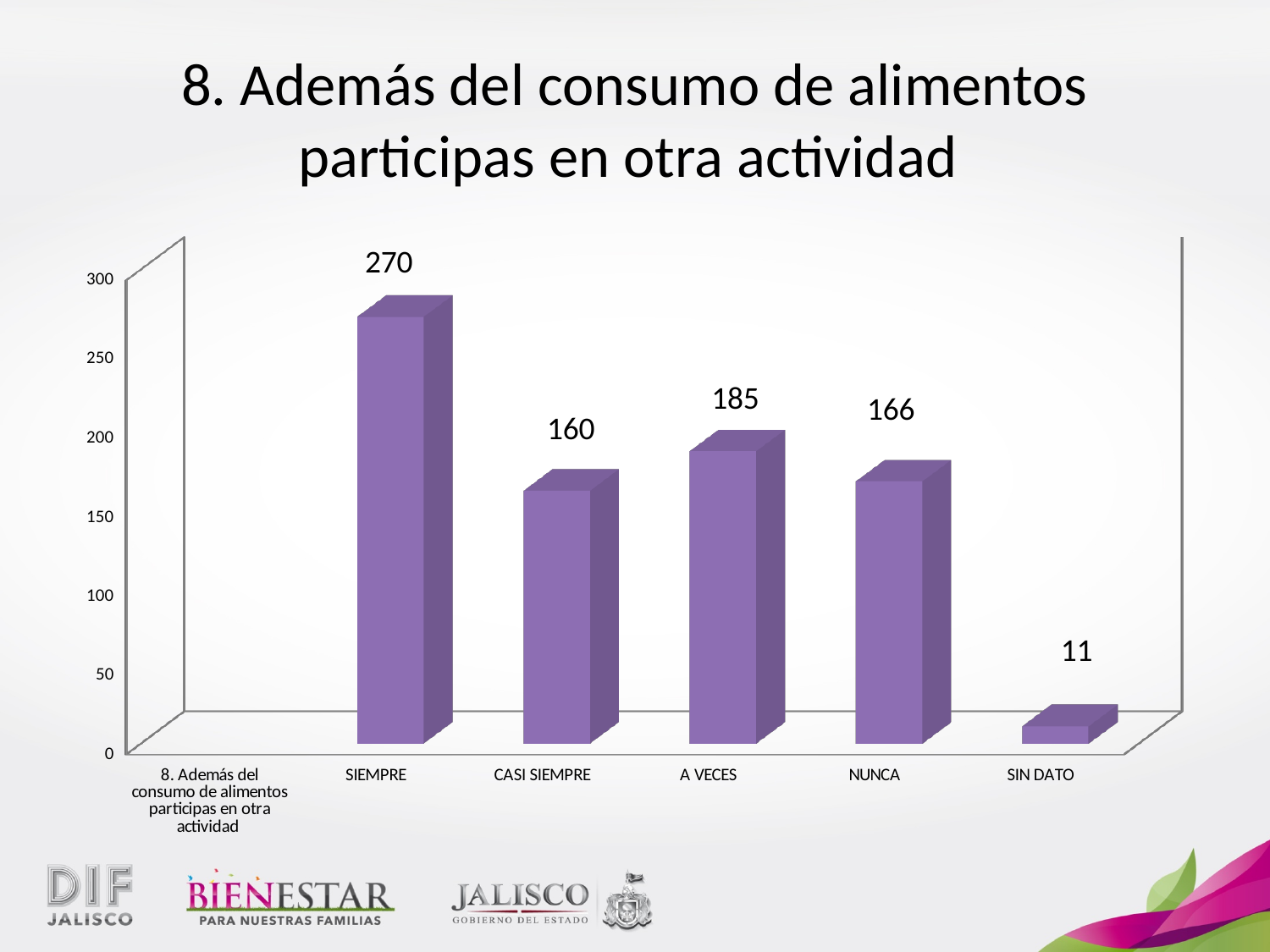
Which category has the lowest value? SIN DATO What is the title of the slide? 8. Además del consumo de alimentos participas en otra actividad What is the value for NUNCA? 166 Which is larger, the value for A VECES or the value for NUNCA? A VECES Which category has the highest value? SIEMPRE What is the value for SIEMPRE? 270 What is the value for SIN DATO? 11 What kind of chart is shown on the slide? Bar chart What is the value for A VECES? 185 How many labelled categories with bars are shown in the chart? 5 What is the difference between the values for SIEMPRE and CASI SIEMPRE? 110 What is the value for CASI SIEMPRE? 160